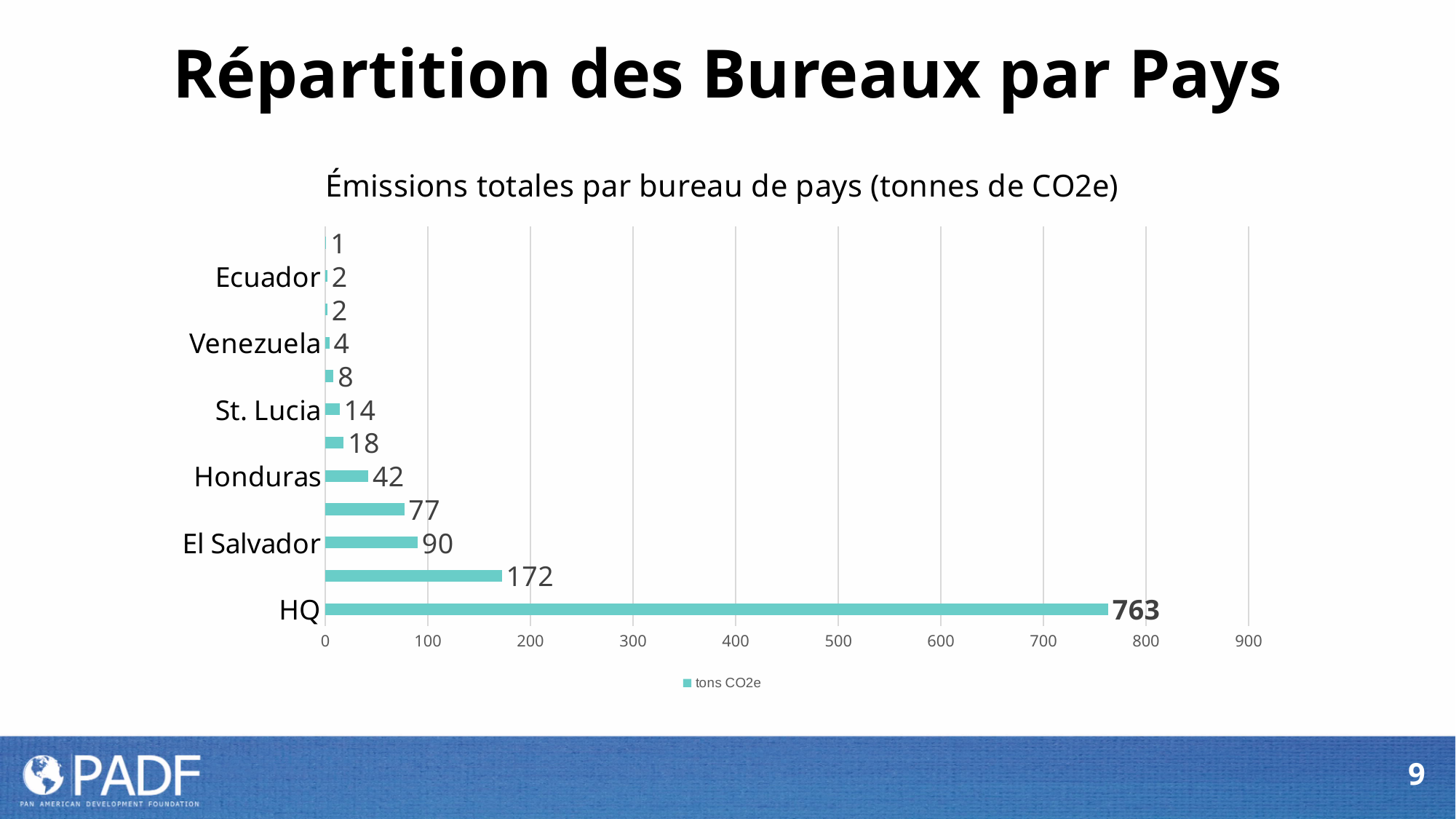
How many series does the legend list? 1 Which is larger, the value for Honduras or the value for St. Lucia? Honduras What is the value for St. Lucia? 14 What is the value for Honduras? 42 What kind of chart is shown on the slide? bar chart Which office has the highest emissions? HQ What is the value for El Salvador? 90 What is the value for Venezuela? 4 What is the value for Ecuador? 2 What is the value for HQ? 763 What is the difference between the values for HQ and El Salvador? 673 How many bars are plotted in the chart? 12